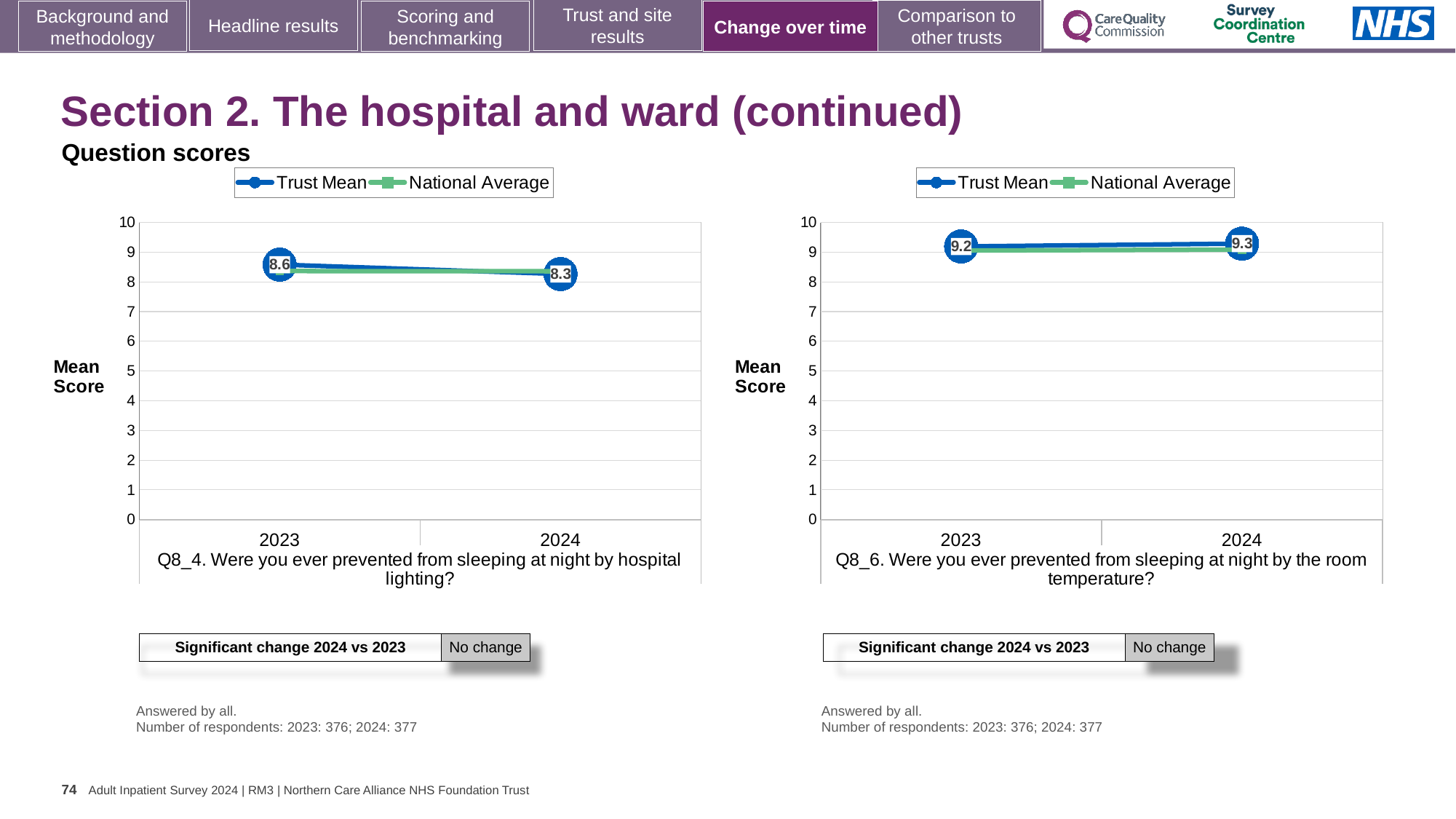
On the left chart (Q8_4, hospital lighting), what is the Trust Mean score for 2024? 8.3 On the left chart (Q8_4, hospital lighting), by how much did the Trust Mean change from 2023 to 2024? 0.3 What type of chart is the right chart (Q8_6, room temperature)? line chart On the right chart (Q8_6, room temperature), what is the difference between the Trust Mean scores for 2024 and 2023? 0.1 On the left chart (Q8_4, hospital lighting), what is the Trust Mean score for 2023? 8.6 How many series does the legend of the left chart (Q8_4, hospital lighting) list? 2 On the right chart (Q8_6, room temperature), does the Trust Mean rise or fall from 2023 to 2024? rise On the right chart (Q8_6, room temperature), what is the Trust Mean score for 2023? 9.2 On the left chart (Q8_4, hospital lighting), is the Trust Mean for 2024 greater or less than 9? less On the right chart (Q8_6, room temperature), is the Trust Mean for 2023 greater or less than 9? greater On the left chart (Q8_4, hospital lighting), does the Trust Mean rise or fall from 2023 to 2024? fall On the right chart (Q8_6, room temperature), what is the Trust Mean score for 2024? 9.3